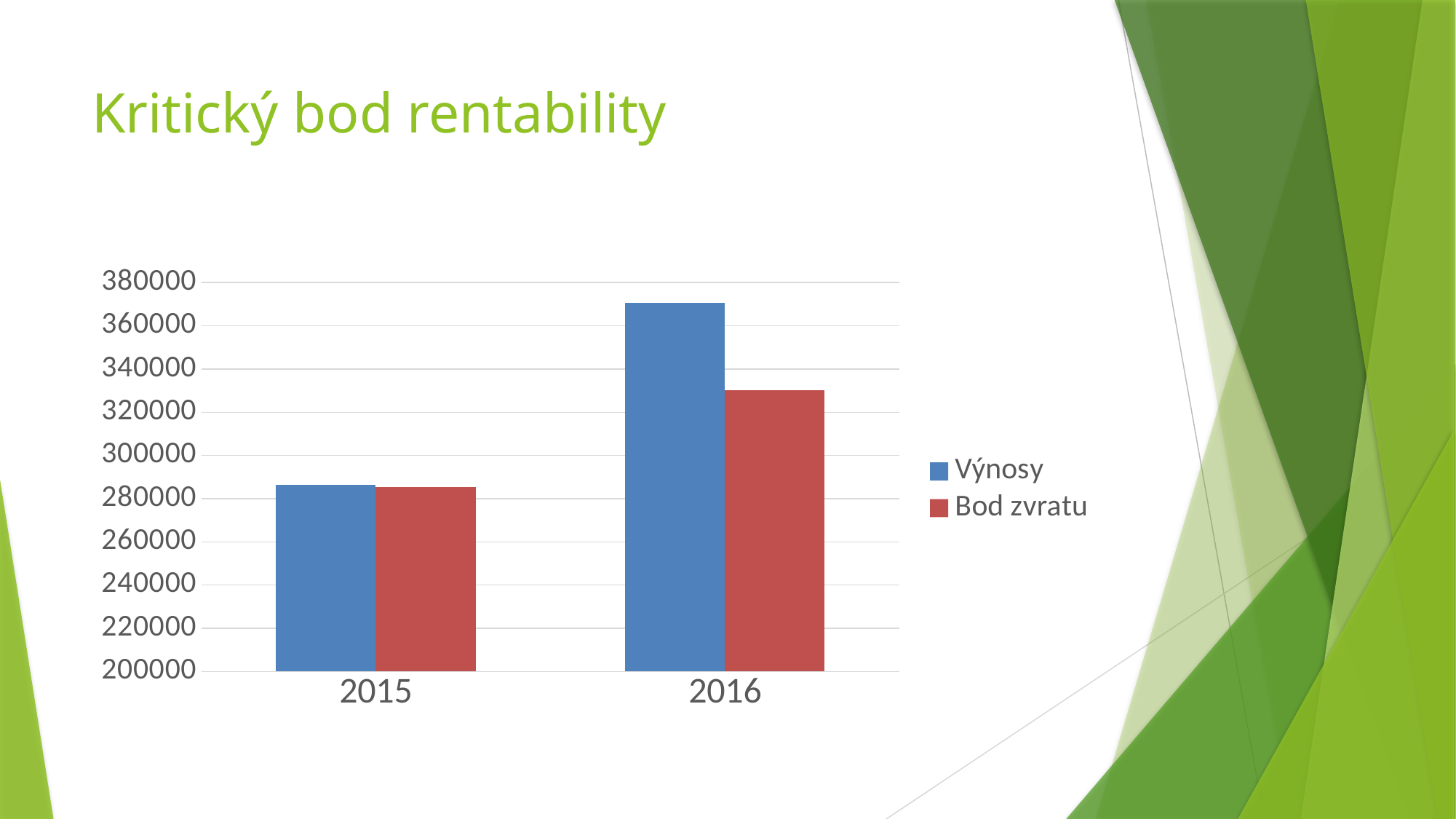
Is the value for Výnosy in 2015 greater or less than 300000? less Which series are listed in the legend? Výnosy, Bod zvratu In 2016, which is larger, Výnosy or Bod zvratu? Výnosy Do the Výnosy values rise or fall from 2015 to 2016? rise Which year has the highest Výnosy value? 2016 Is the value for Bod zvratu in 2016 greater or less than 340000? less Is the value for Výnosy in 2016 greater or less than 360000? greater What kind of chart is shown on the slide? bar chart What is the title of the slide containing the chart? Kritický bod rentability How many series does the legend list? 2 How many categories are shown on the x axis? 2